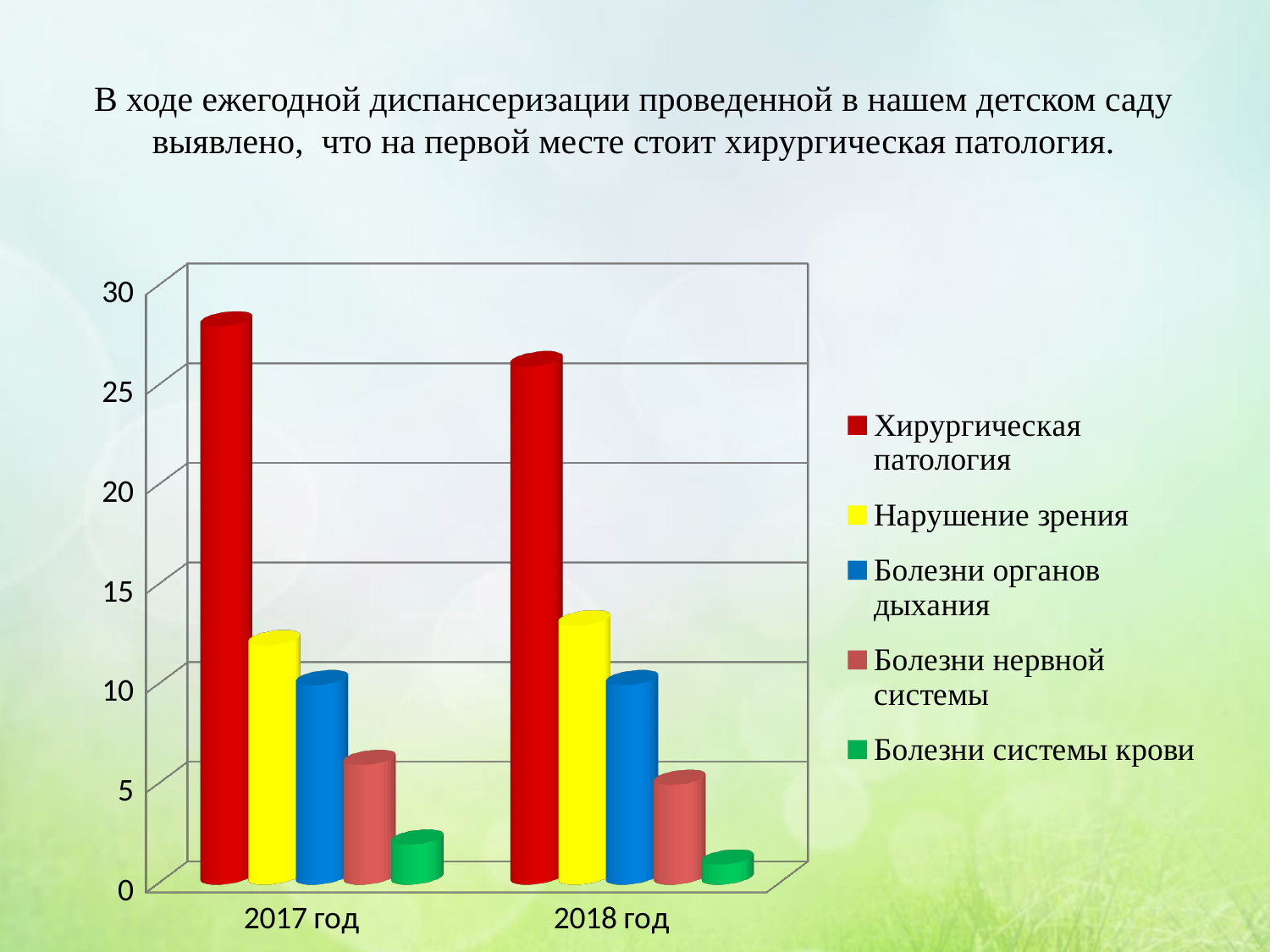
Is the value for Нарушение зрения in 2017 год greater or less than 10? greater Is the value for Хирургическая патология in 2018 год greater or less than 20? greater Which series has the highest value for 2017 год? Хирургическая патология How many series does the legend list? 5 Which series has the lowest value for 2018 год? Болезни системы крови Is the value for Болезни нервной системы in 2018 год greater or less than 10? less How many categories (years) are shown on the x axis? 2 Which is larger: Хирургическая патология in 2017 год or in 2018 год? 2017 год What kind of chart is shown on the slide? bar chart Does the value for Хирургическая патология rise or fall from 2017 год to 2018 год? fall